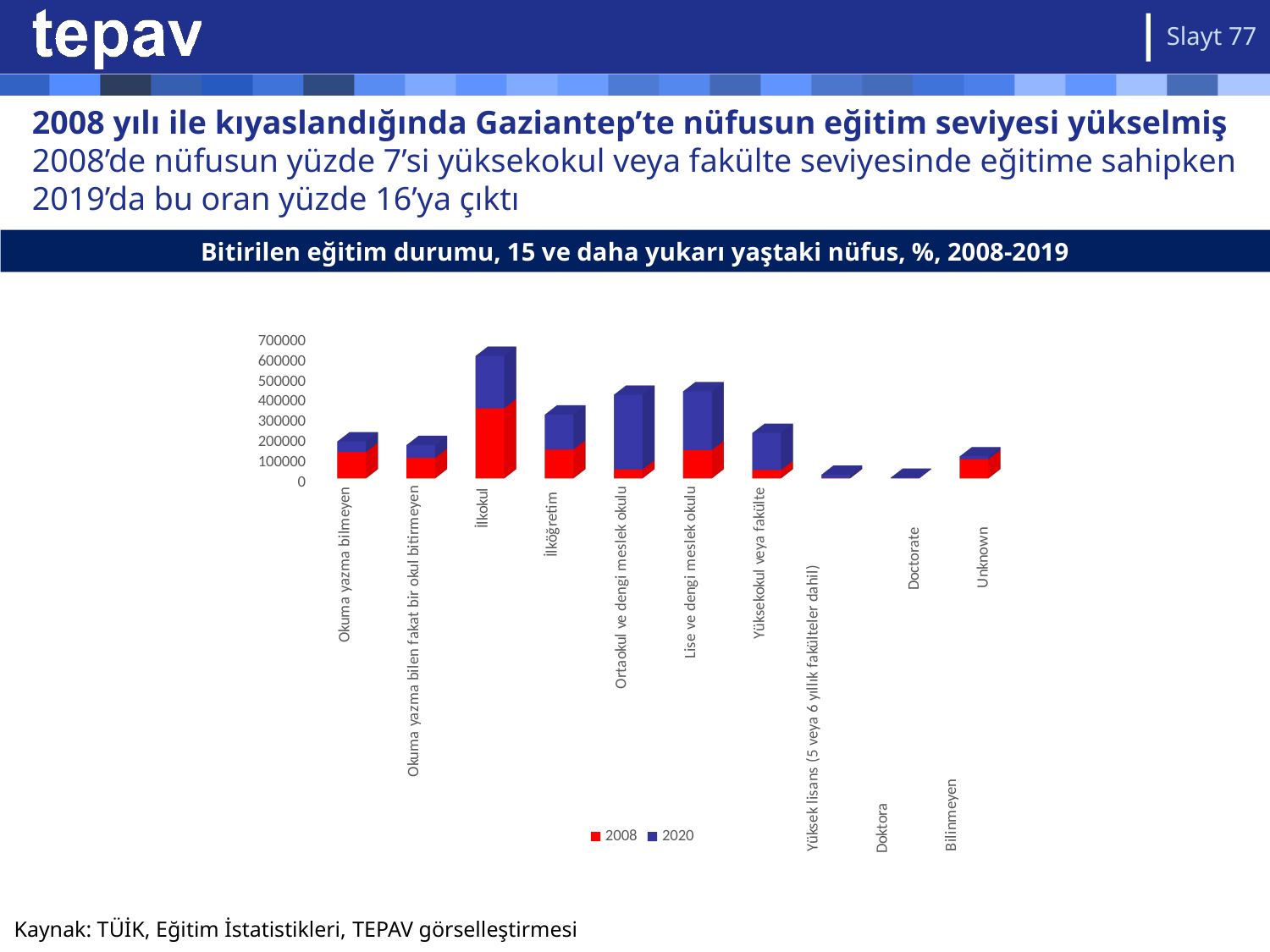
Which series does the legend list? 2008 and 2020 How many education categories are shown on the x axis? 10 Which has the larger total bar, Lise ve dengi meslek okulu or Okuma yazma bilmeyen? Lise ve dengi meslek okulu Is the total value for Okuma yazma bilmeyen greater or less than 300000? less Is the total value for İlkokul greater or less than 500000? greater Which category has the lowest total bar? Doktora What kind of chart is shown on the slide? Stacked bar chart Which has the larger total bar, Ortaokul ve dengi meslek okulu or Yüksekokul veya fakülte? Ortaokul ve dengi meslek okulu What is the title of the chart? Bitirilen eğitim durumu, 15 ve daha yukarı yaştaki nüfus, %, 2008-2019 Is the total value for Lise ve dengi meslek okulu greater or less than 300000? greater How many series does the legend list? 2 Which category has the highest total bar? İlkokul